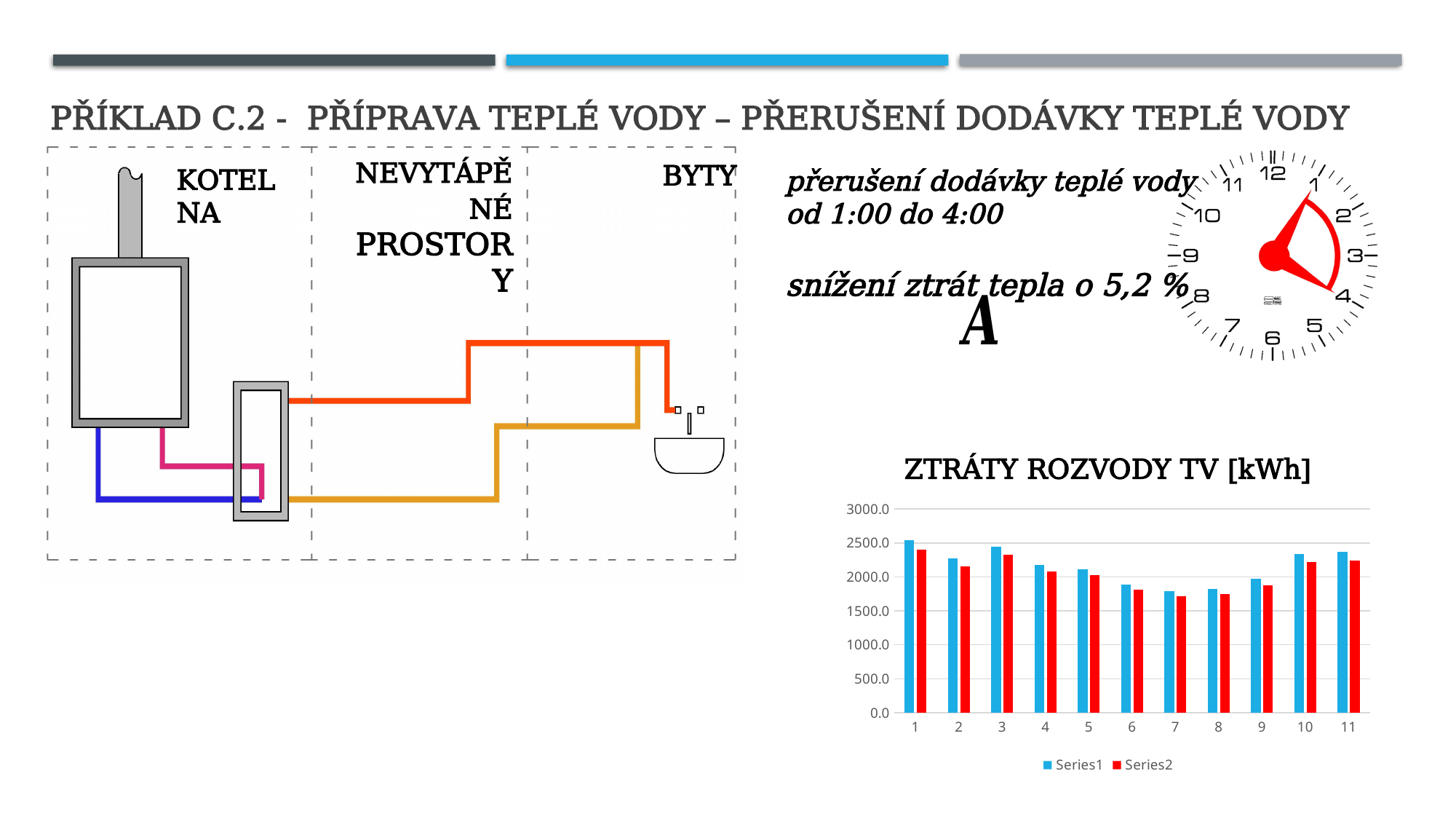
For category 1, which series has the larger value, Series1 or Series2? Series1 Which category has the highest Series2 value in the chart? 1 What are the names of the series listed in the chart's legend? Series1, Series2 Is the Series2 value for category 10 greater or less than 2000.0? greater How many categories are shown on the x axis of the chart? 11 What type of chart is shown on the slide? bar chart What is the title of the chart on the slide? ZTRÁTY ROZVODY TV [kWh] Do the Series1 values rise or fall from category 1 to category 7? fall Is the Series1 value for category 6 greater or less than 2000.0? less How many series does the chart's legend list? 2 Which category has the highest Series1 value in the chart? 1 Is the Series1 value for category 7 greater or less than 2000.0? less